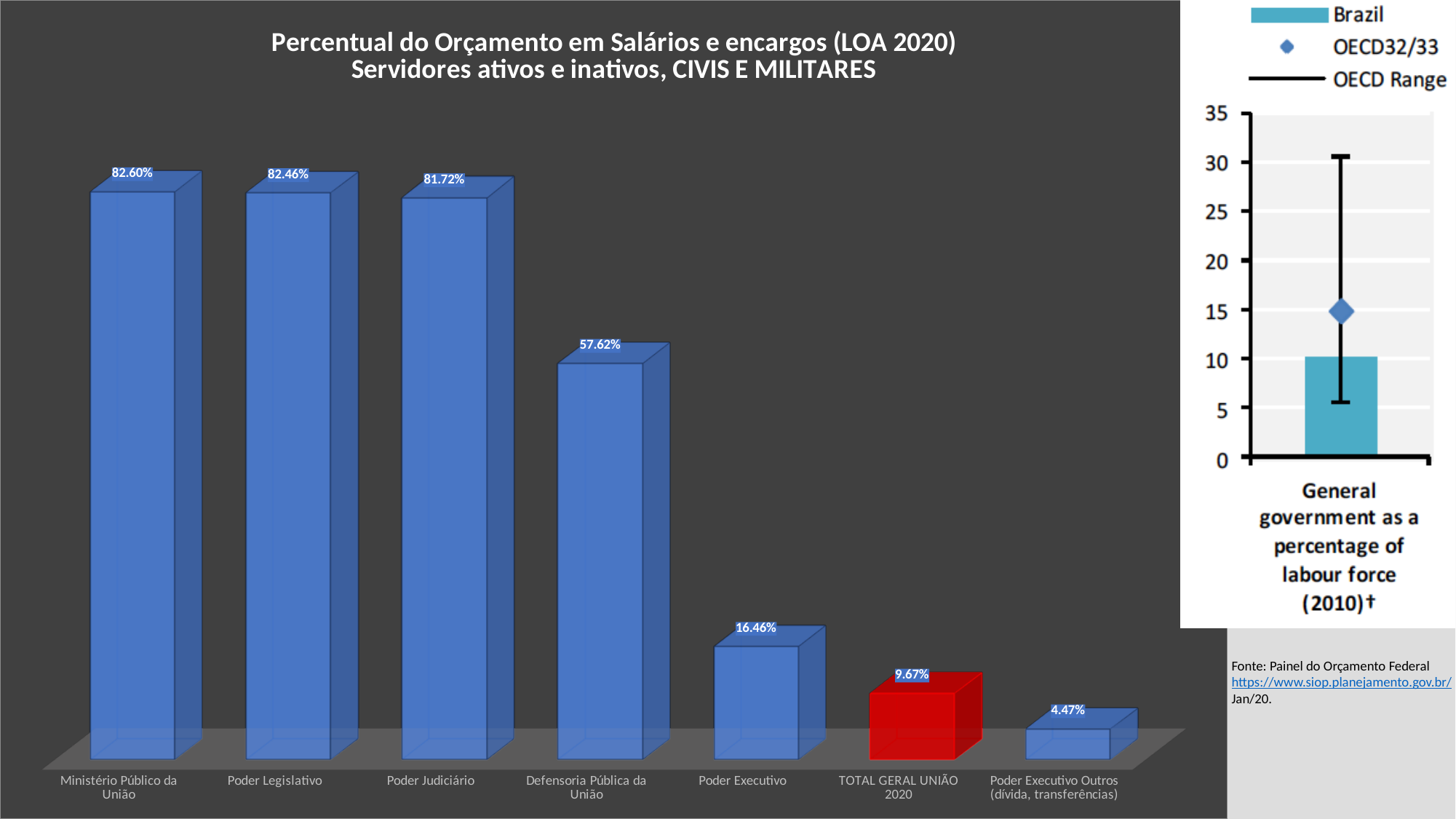
In the chart 'Percentual do Orçamento em Salários e encargos (LOA 2020)', what is the value for Defensoria Pública da União? 57.62% In the chart 'Percentual do Orçamento em Salários e encargos (LOA 2020)', which category has the lowest value? Poder Executivo Outros (dívida, transferências) In the chart on the right ('General government as a percentage of labour force (2010)'), is the value for Brazil greater or less than 15? less How many categories are shown in the chart 'Percentual do Orçamento em Salários e encargos (LOA 2020)'? 7 In the chart 'Percentual do Orçamento em Salários e encargos (LOA 2020)', which category has the highest value? Ministério Público da União In the chart 'Percentual do Orçamento em Salários e encargos (LOA 2020)', what is the value for Poder Judiciário? 81.72% In the chart 'Percentual do Orçamento em Salários e encargos (LOA 2020)', which is larger: Poder Legislativo or Poder Judiciário? Poder Legislativo How many entries does the legend of the chart on the right ('General government as a percentage of labour force (2010)') list? 3 In the chart 'Percentual do Orçamento em Salários e encargos (LOA 2020)', which bar is coloured red? TOTAL GERAL UNIÃO 2020 What kind of chart is 'Percentual do Orçamento em Salários e encargos (LOA 2020)'? Bar chart In the chart 'Percentual do Orçamento em Salários e encargos (LOA 2020)', what is the difference between Poder Executivo and TOTAL GERAL UNIÃO 2020? 6.79% In the chart 'Percentual do Orçamento em Salários e encargos (LOA 2020)', what is the value for TOTAL GERAL UNIÃO 2020? 9.67%